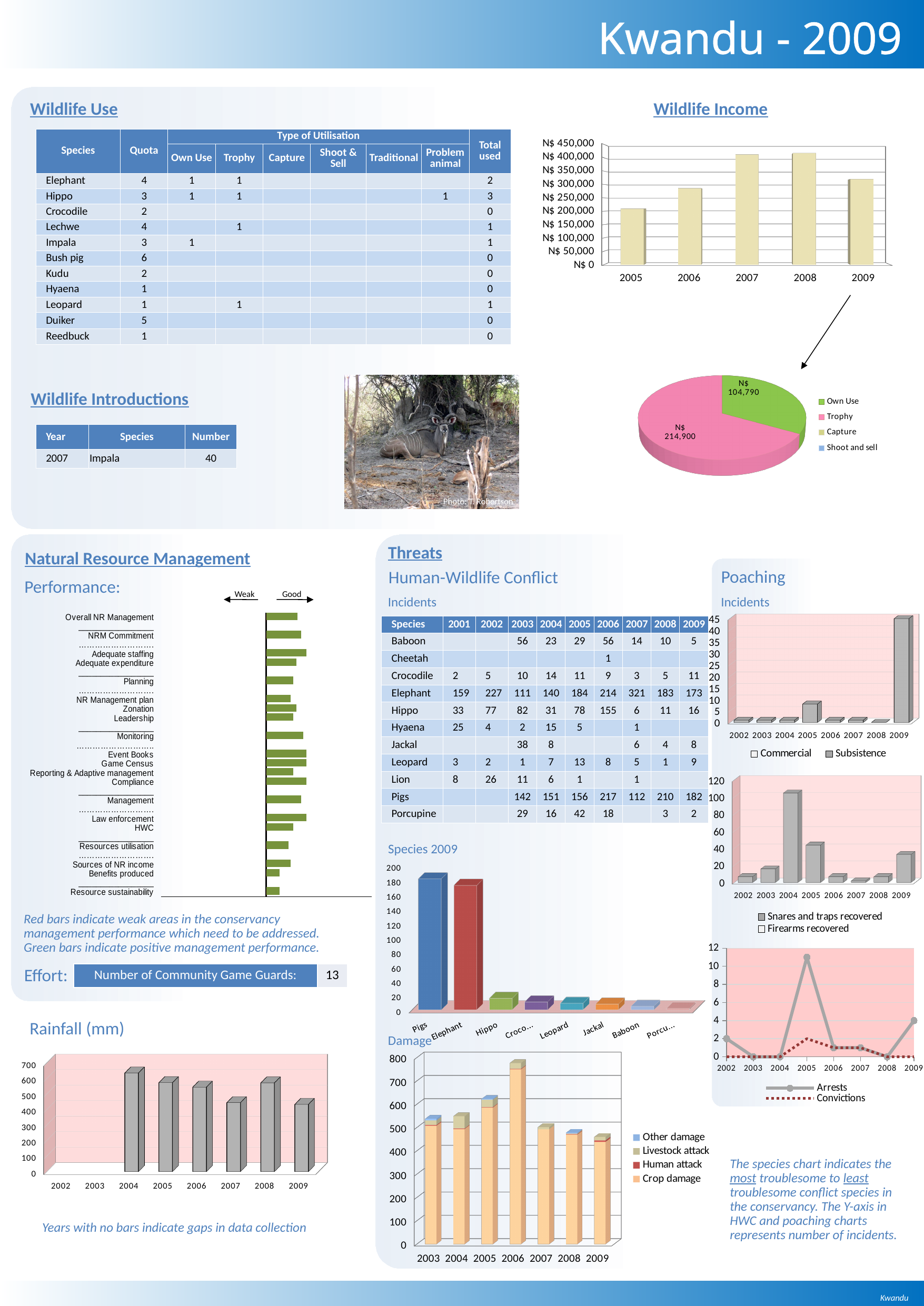
In the Wildlife Income pie chart, what is the value for Trophy? N$ 214,900 In the Rainfall (mm) chart, is the value for 2007 greater or less than 500? less In the Wildlife Income bar chart, is the value for 2009 greater or less than N$ 300,000? greater In the Arrests and Convictions line chart, is the number of Arrests in 2005 greater or less than 10? greater In the Wildlife Income pie chart, what is the value for Own Use? N$ 104,790 How many entries does the legend of the Wildlife Income pie chart list? 4 In the Rainfall (mm) chart, which year has the highest rainfall? 2004 In the Species 2009 chart, which species has the highest number of incidents? Pigs In the Wildlife Income bar chart, which year has the lowest income? 2005 How many species are shown in the Species 2009 bar chart? 8 In the Poaching Incidents chart (Commercial/Subsistence), which year has the highest value? 2009 In the Wildlife Income pie chart, how much larger is the Trophy value than the Own Use value? N$ 110,110